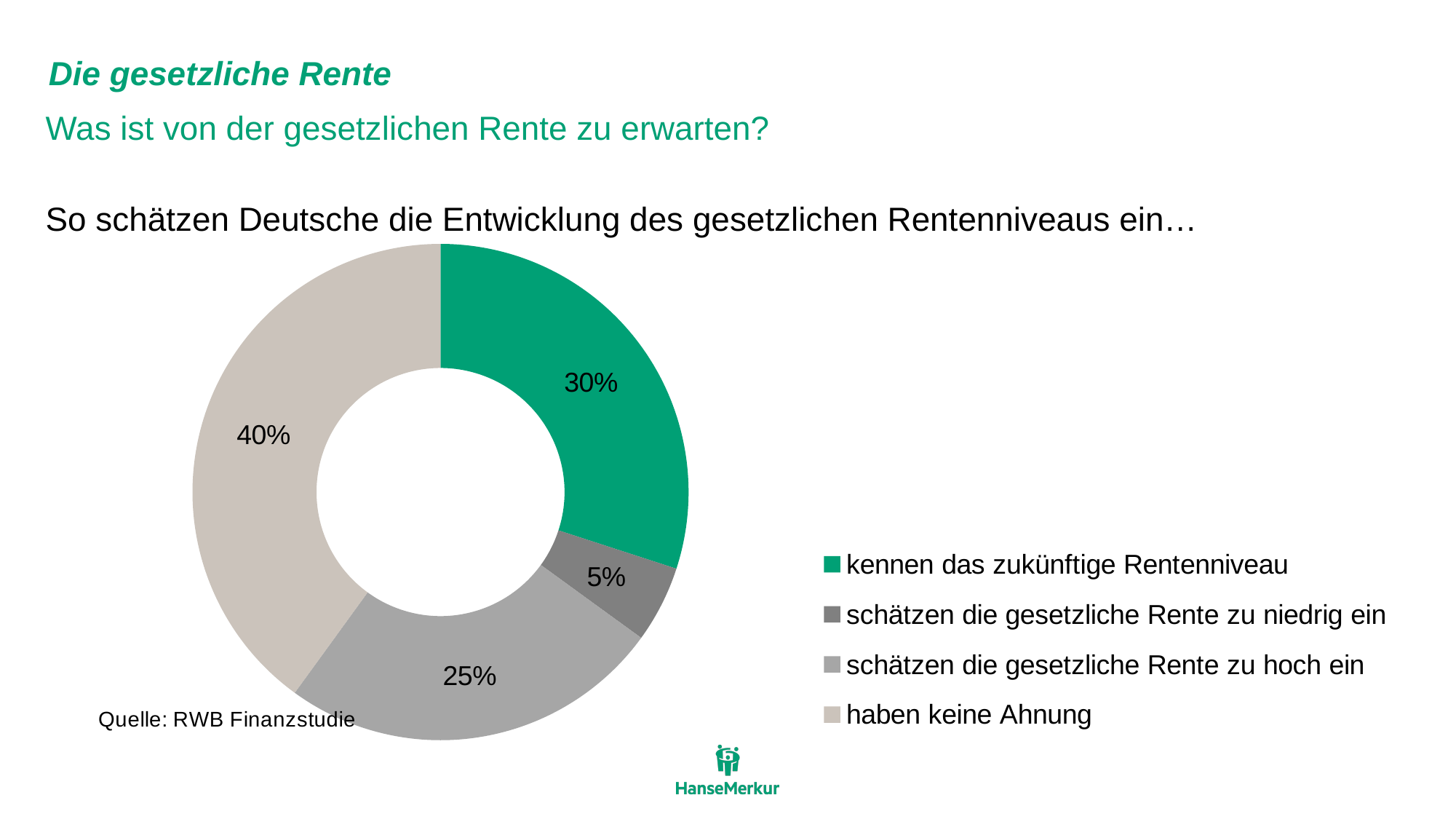
How many categories does the chart show? 4 What kind of chart is shown on the slide? Doughnut (pie) chart Which category has the smallest share of the chart? schätzen die gesetzliche Rente zu niedrig ein What percentage of respondents 'schätzen die gesetzliche Rente zu niedrig ein'? 5% Which category has the largest share of the chart? haben keine Ahnung What is the combined share of the two categories that misjudge the pension (zu niedrig and zu hoch)? 30% What is the difference in percentage points between 'haben keine Ahnung' and 'kennen das zukünftige Rentenniveau'? 10 percentage points Which colour represents 'kennen das zukünftige Rentenniveau' in the chart? Green Which is larger: the share for 'schätzen die gesetzliche Rente zu hoch ein' or for 'schätzen die gesetzliche Rente zu niedrig ein'? schätzen die gesetzliche Rente zu hoch ein What percentage of respondents 'kennen das zukünftige Rentenniveau'? 30% What percentage of respondents 'schätzen die gesetzliche Rente zu hoch ein'? 25% What percentage of respondents 'haben keine Ahnung'? 40%